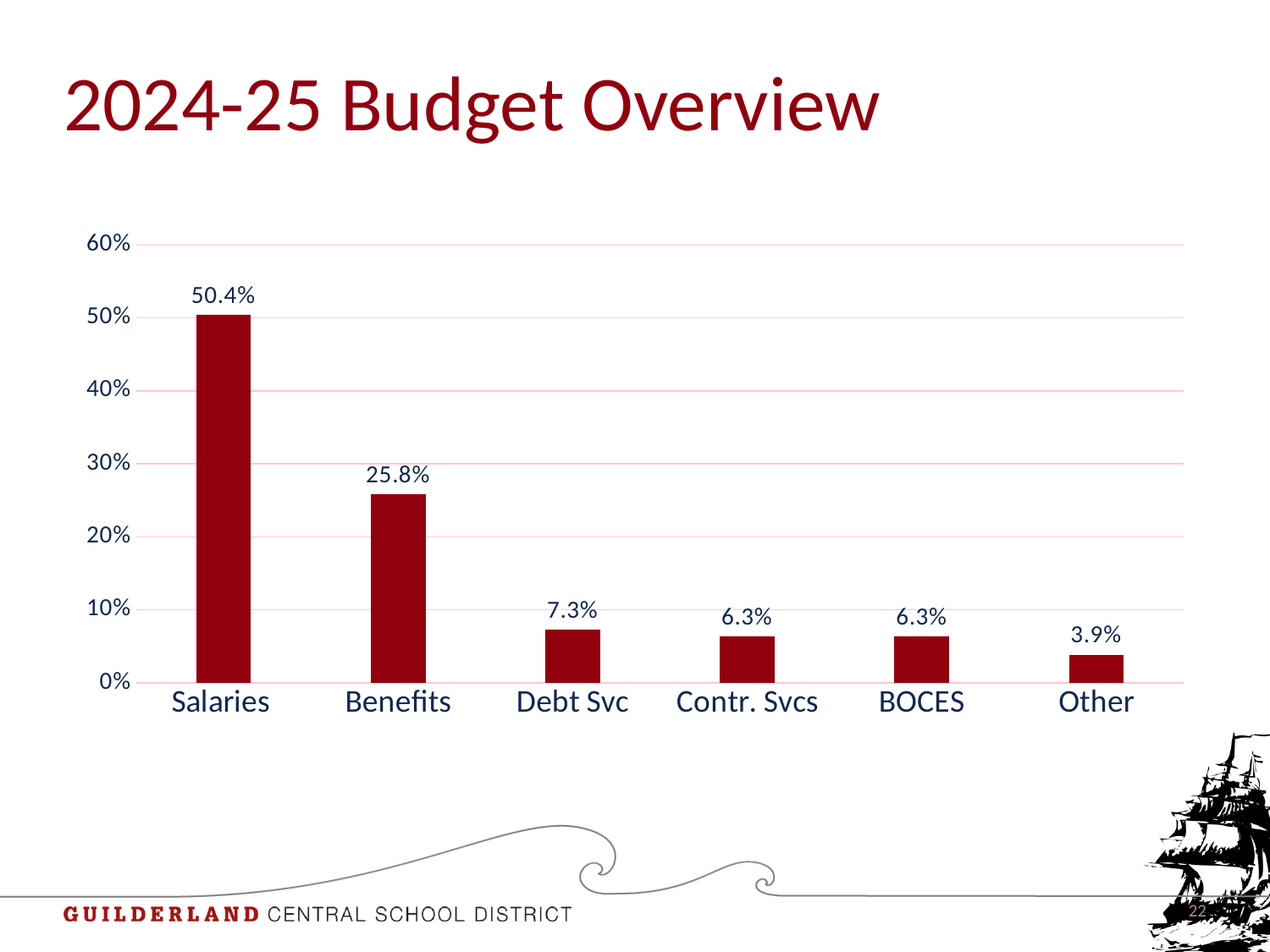
What is the difference between the values for Debt Svc and Other? 3.4% Which category has the lowest value? Other Which is larger, the value for Benefits or the value for Debt Svc? Benefits What is the value for Debt Svc? 7.3% What is the value for Benefits? 25.8% How many categories are shown on the x axis? 6 What is the value for Other? 3.9% Is the value for Salaries greater or less than 50%? greater What is the difference between the values for Salaries and Benefits? 24.6% Which category has the highest value? Salaries What is the value for Salaries? 50.4% What kind of chart is shown on the slide? Bar chart